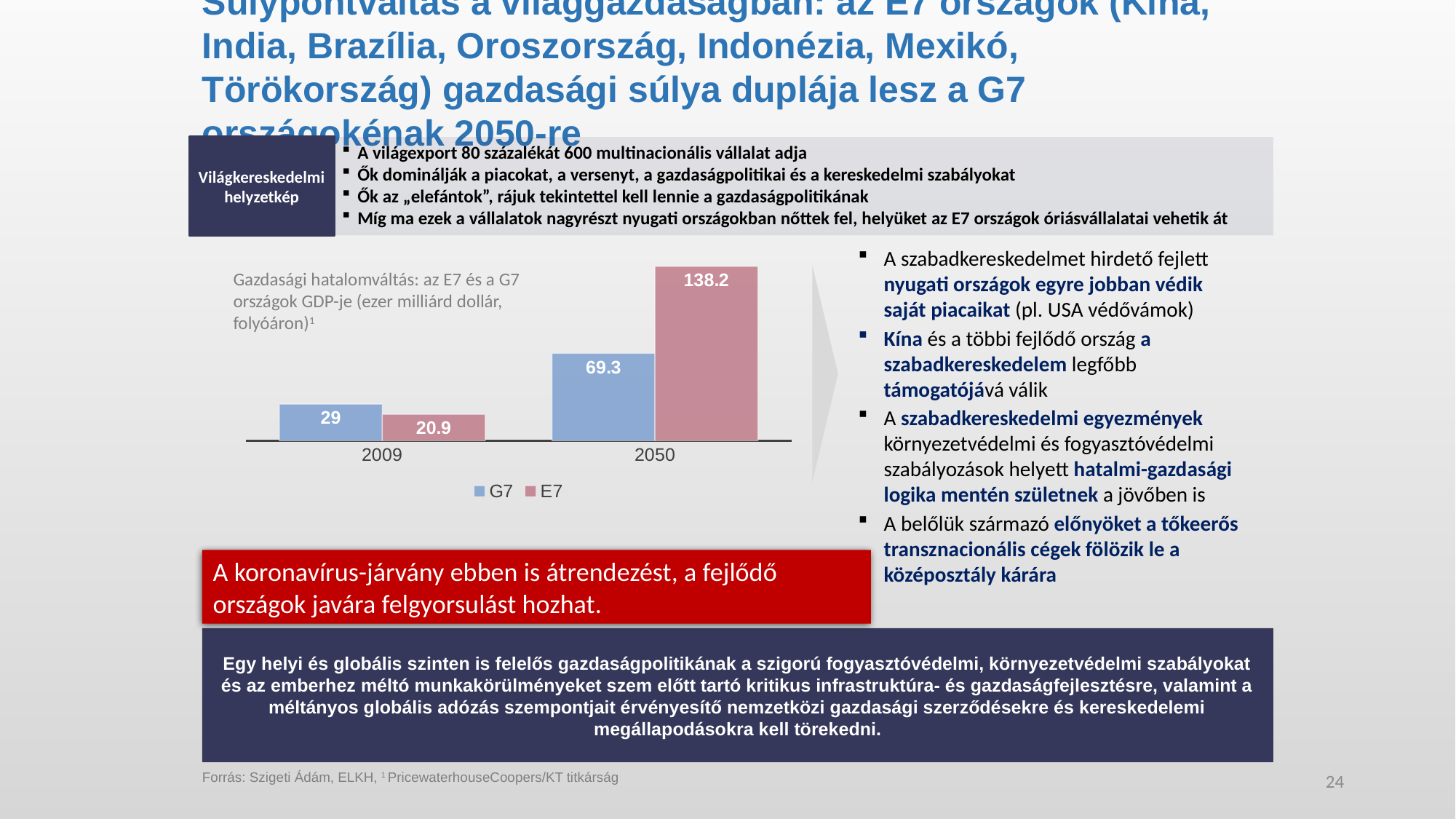
What is the value for G7 in 2050? 69.3 Which is larger in 2009, G7 or E7? G7 What is the difference between the E7 and G7 values in 2050? 68.9 What is the value for E7 in 2050? 138.2 How many categories are shown on the x axis? 2 What is the value for E7 in 2009? 20.9 How many series does the legend list? 2 Which bar has the lowest value in the chart? E7 in 2009 Which series has the highest value in 2050? E7 What kind of chart is shown on the slide? Bar chart What is the value for G7 in 2009? 29 Does the E7 value rise or fall from 2009 to 2050? Rise